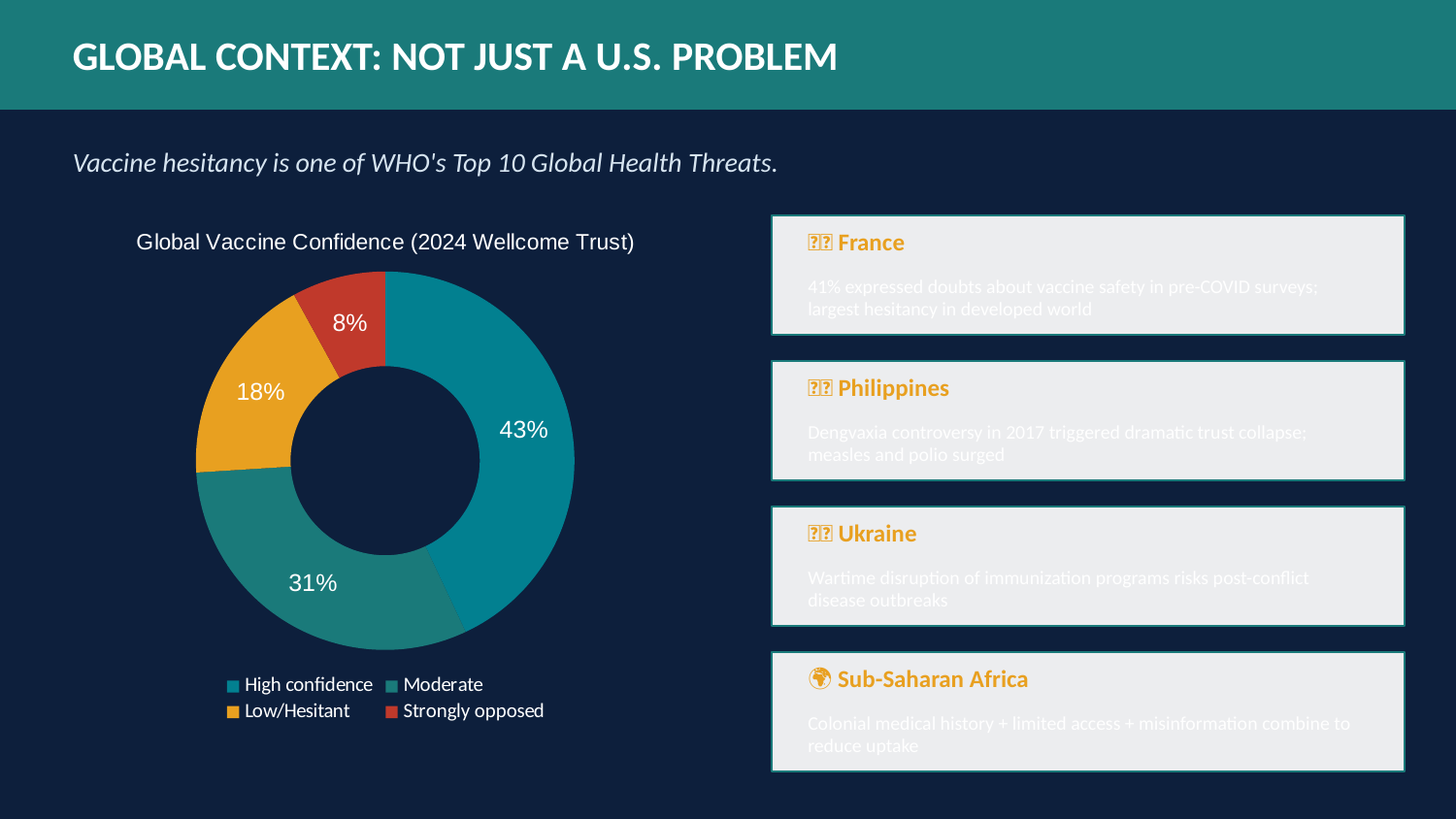
What is the difference between the High confidence share and the Moderate share? 12% What share of the chart is labelled Moderate? 31% What kind of chart is shown on the slide? Donut (pie) chart What share of the chart is labelled Strongly opposed? 8% Which is larger, the Low/Hesitant share or the Strongly opposed share? Low/Hesitant What share of the chart is labelled Low/Hesitant? 18% How many categories does the chart's legend list? 4 What is the title of the chart? Global Vaccine Confidence (2024 Wellcome Trust) Which category has the largest share of the chart? High confidence What share of the chart is labelled High confidence? 43% What is the combined share of the Low/Hesitant and Strongly opposed categories? 26% Which category has the smallest share of the chart? Strongly opposed